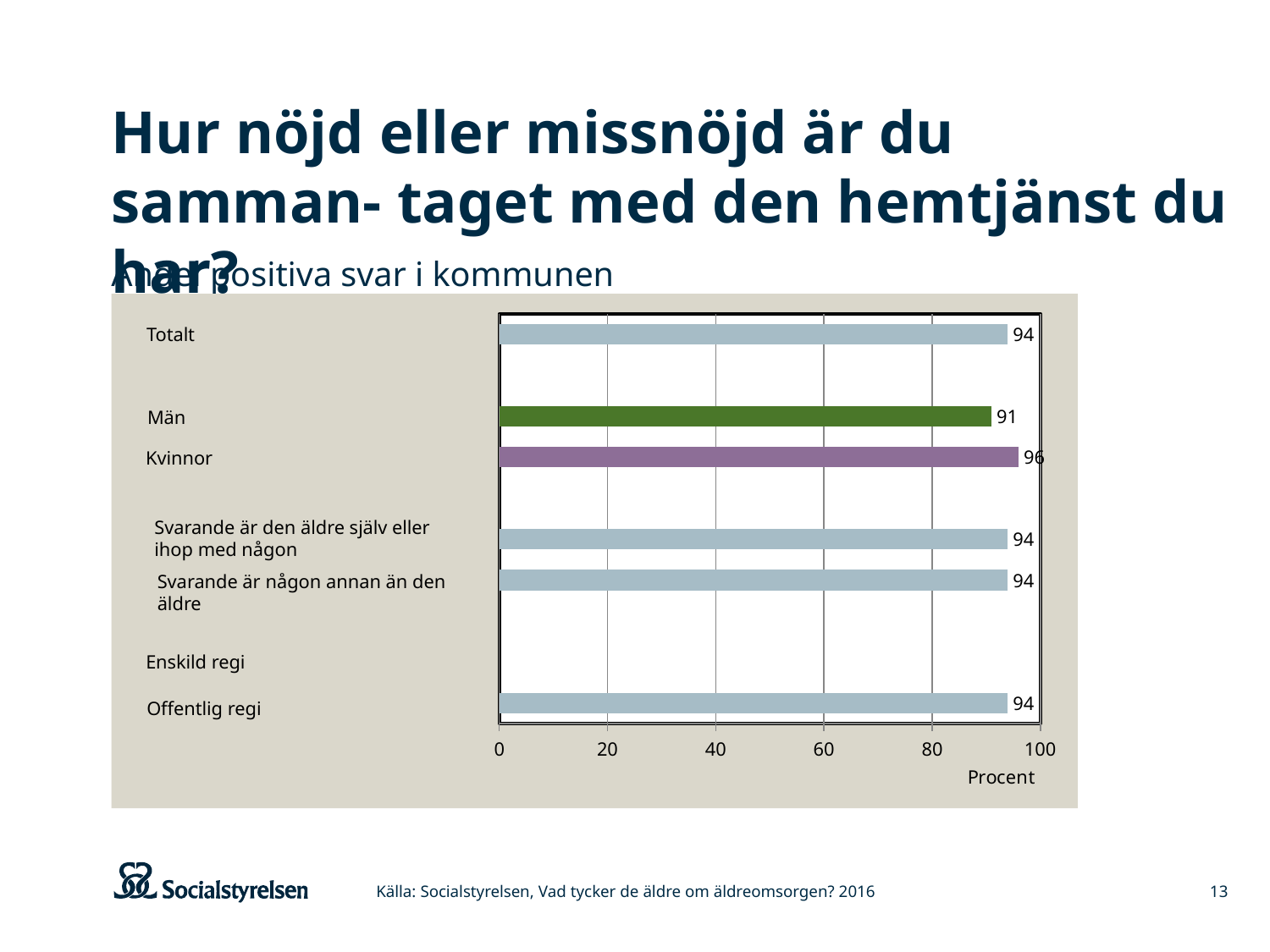
What is the value for Kvinnor? 96 What is the value for Totalt? 94 Which is larger, the value for Män or the value for Kvinnor? Kvinnor Which category has the highest value? Kvinnor What is the label of the x axis? Procent Which category has the lowest value? Män Is the value for Män greater or less than 80? greater What is the value for Offentlig regi? 94 What is the value for Män? 91 What kind of chart is shown? bar chart How many bars are plotted in the chart? 6 What is the difference between the values for Kvinnor and Män? 5